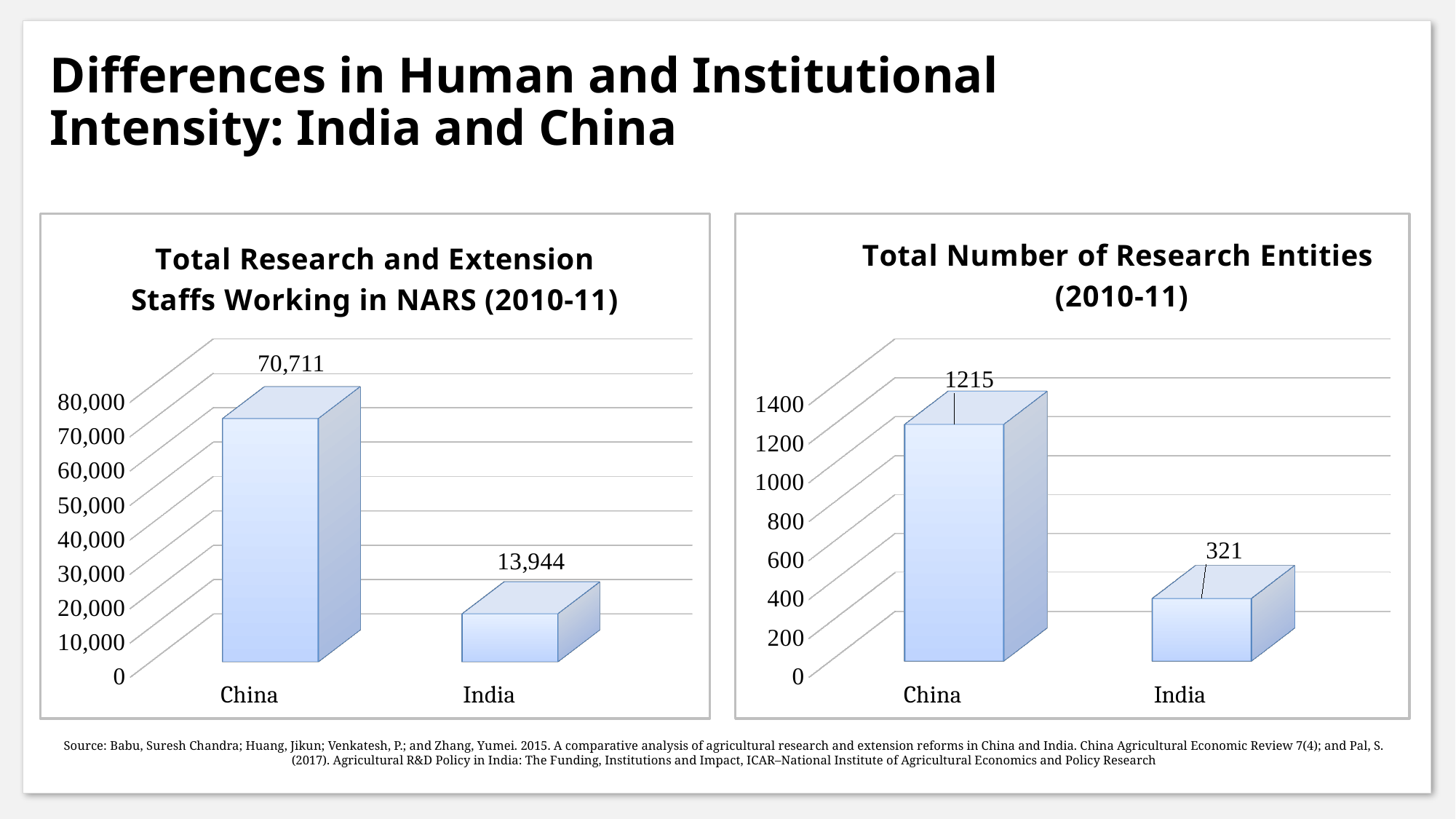
What is the title of the chart on the left side of the slide? Total Research and Extension Staffs Working in NARS (2010-11) In the 'Total Number of Research Entities (2010-11)' chart, what is the value for India? 321 In the 'Total Number of Research Entities (2010-11)' chart, is the value for India greater or less than 400? less In the 'Total Number of Research Entities (2010-11)' chart, which country has the lower value? India In the 'Total Research and Extension Staffs Working in NARS (2010-11)' chart, what is the value for China? 70,711 In the 'Total Research and Extension Staffs Working in NARS (2010-11)' chart, which country has the higher value? China In the 'Total Number of Research Entities (2010-11)' chart, what is the value for China? 1215 How many categories are shown in the 'Total Research and Extension Staffs Working in NARS (2010-11)' chart? 2 In the 'Total Number of Research Entities (2010-11)' chart, what is the difference between the values for China and India? 894 In the 'Total Research and Extension Staffs Working in NARS (2010-11)' chart, what is the difference between the values for China and India? 56,767 In the 'Total Research and Extension Staffs Working in NARS (2010-11)' chart, what is the value for India? 13,944 What kind of chart is the 'Total Number of Research Entities (2010-11)' chart? Bar chart